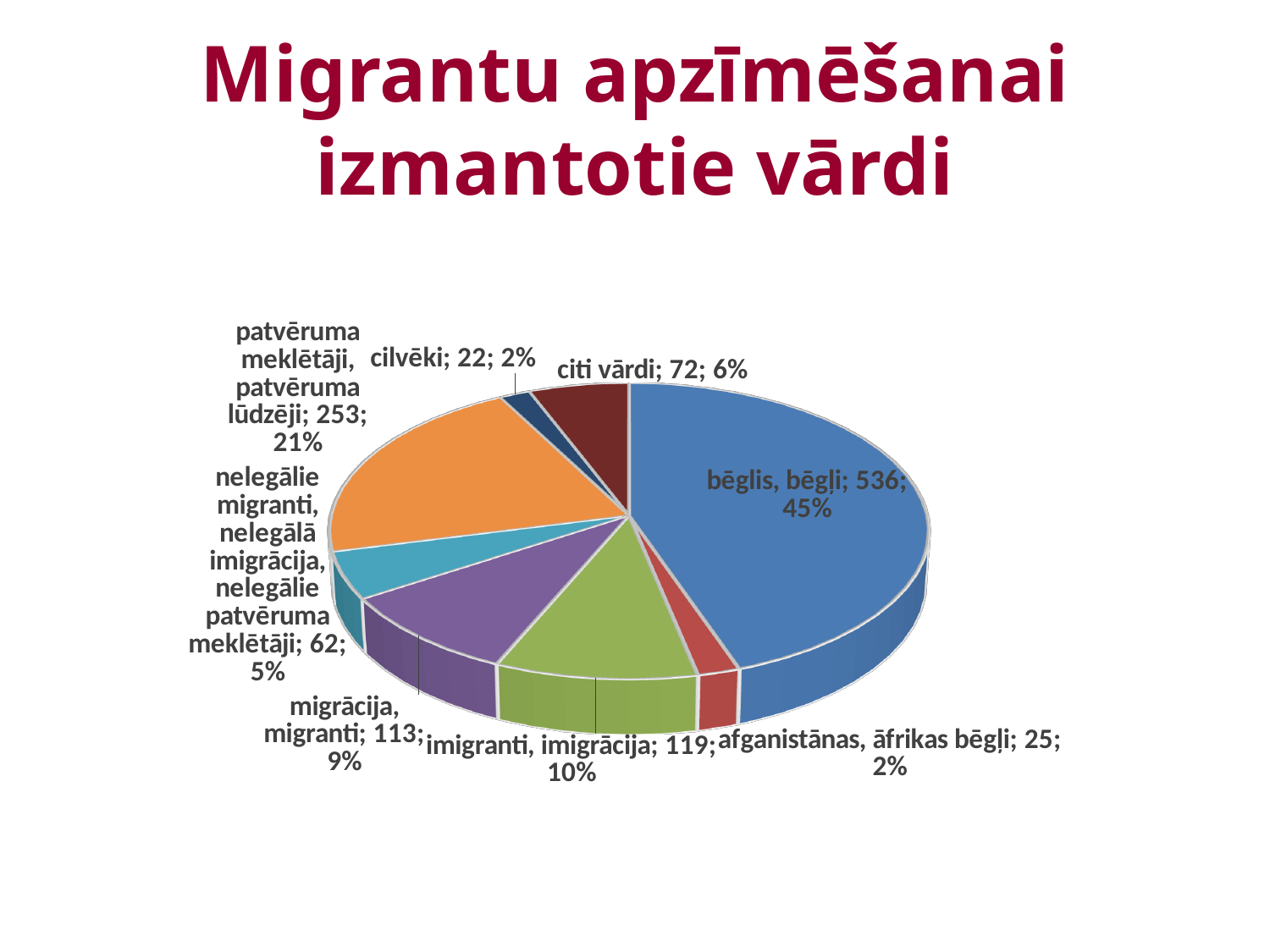
What share of the pie does "bēglis, bēgļi" represent? 45% What is the value for "patvēruma meklētāji, patvēruma lūdzēji"? 253 How many slices does the pie chart have? 8 What type of chart is shown on the slide? pie chart Which is larger, the value for "citi vārdi" or the value for "nelegālie migranti, nelegālā imigrācija, nelegālie patvēruma meklētāji"? citi vārdi What percentage is shown for "imigranti, imigrācija"? 10% Which category has the largest slice of the pie? bēglis, bēgļi What is the difference between the values for "imigranti, imigrācija" and "migrācija, migranti"? 6 What is the title of the slide? Migrantu apzīmēšanai izmantotie vārdi Which category has the smallest value? cilvēki What is the value for "cilvēki"? 22 What is the value for "bēglis, bēgļi"? 536